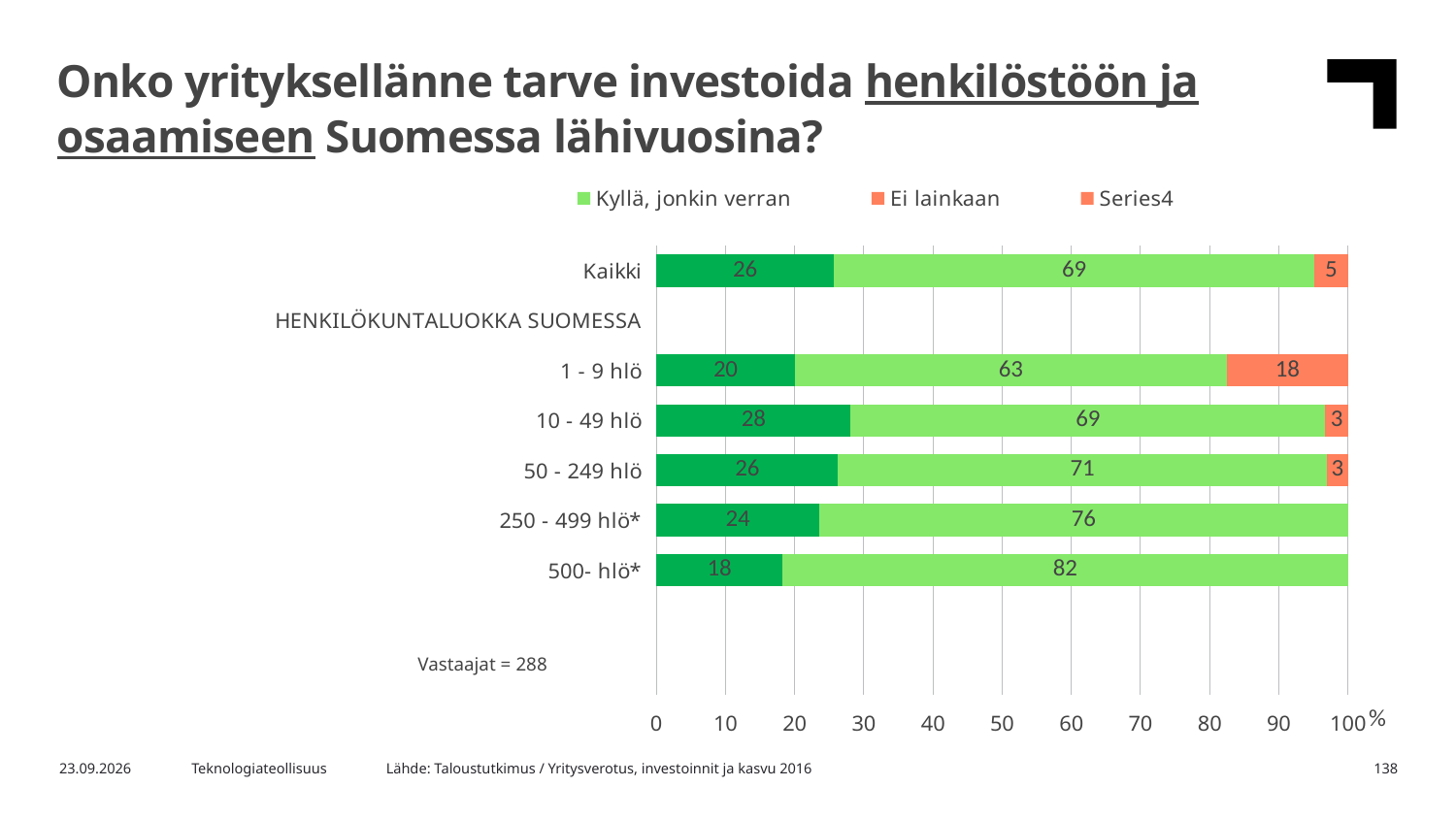
What is the difference between the 'Kyllä, jonkin verran' values for '500- hlö*' and '1 - 9 hlö'? 19 How many bars are plotted in the chart? 6 What is the 'Kyllä, jonkin verran' value for '500- hlö*'? 82 What is the 'Kyllä, jonkin verran' value for 'Kaikki'? 69 What is the total of the stacked bar for 'Kaikki'? 100 What kind of chart is shown on the slide? Stacked bar chart What is the 'Ei lainkaan' value for '1 - 9 hlö'? 18 Which category has the highest 'Ei lainkaan' value? 1 - 9 hlö Which category has the highest 'Kyllä, jonkin verran' value? 500- hlö* How many series does the legend list? 3 Which category has the lowest 'Kyllä, jonkin verran' value? 1 - 9 hlö Which is larger: the 'Kyllä, jonkin verran' value for '250 - 499 hlö*' or for '50 - 249 hlö'? 250 - 499 hlö*